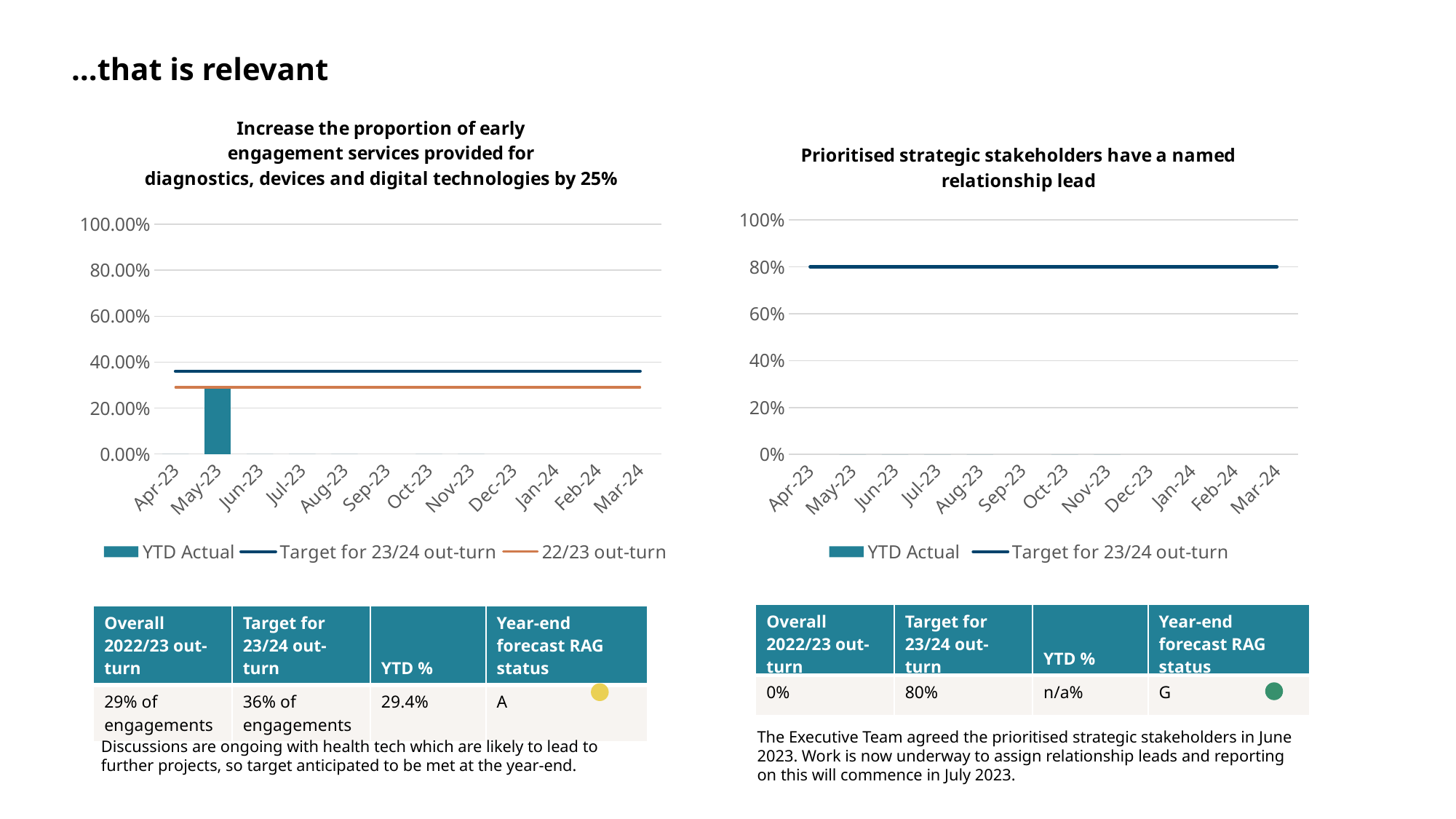
What kind of chart is the left chart ('Increase the proportion of early engagement services...')? Bar chart with line series On the left chart ('Increase the proportion of early engagement services...'), is the 'Target for 23/24 out-turn' line greater or less than 40.00%? less On the left chart ('Increase the proportion of early engagement services...'), how many series does the legend list? 3 On the right chart ('Prioritised strategic stakeholders have a named relationship lead'), how many series does the legend list? 2 On the right chart ('Prioritised strategic stakeholders have a named relationship lead'), is the 'Target for 23/24 out-turn' line greater or less than 60%? greater On the chart titled 'Prioritised strategic stakeholders have a named relationship lead', what value does the 'Target for 23/24 out-turn' line sit at? 80% On the left chart ('Increase the proportion of early engagement services...'), is the YTD Actual bar for May-23 greater or less than 40.00%? less On the left chart ('Increase the proportion of early engagement services...'), which month has a YTD Actual bar plotted? May-23 On the left chart ('Increase the proportion of early engagement services...'), how many months are shown on the x axis? 12 On the left chart ('Increase the proportion of early engagement services...'), which line is higher: 'Target for 23/24 out-turn' or '22/23 out-turn'? Target for 23/24 out-turn On the left chart ('Increase the proportion of early engagement services...'), what is the name of the series drawn in orange? 22/23 out-turn